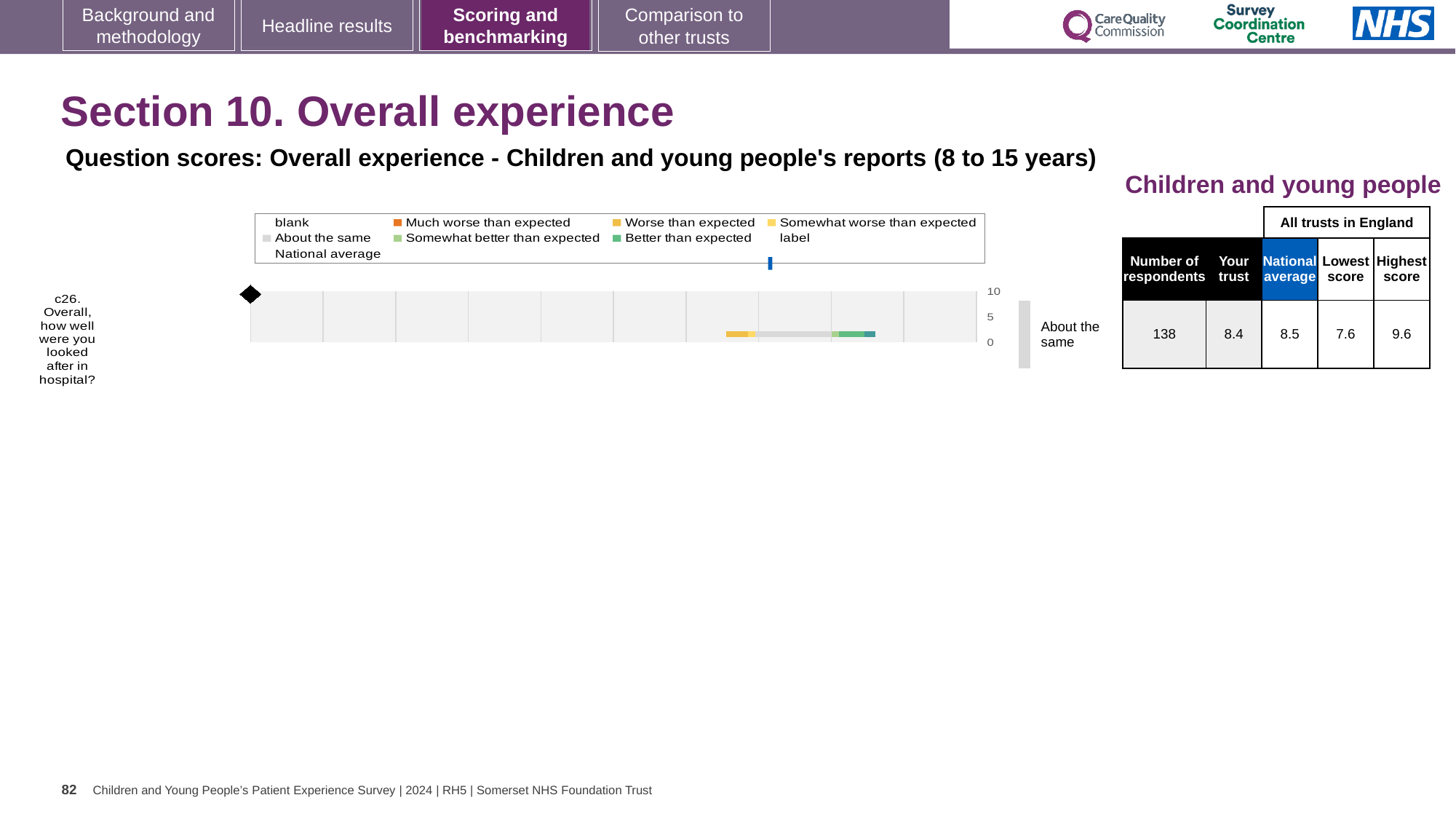
Which survey question is plotted in the chart? c26. Overall, how well were you looked after in hospital? In the table, what is the national average score for question c26? 8.5 What kind of chart is shown on the slide? bar chart What is the difference between the highest score and the lowest score for question c26? 2.0 Which is larger for question c26: the 'Your trust' score or the national average? National average How many survey questions are plotted in the chart? 1 In the table, how many respondents answered question c26? 138 In the table, what is the lowest score among all trusts in England for question c26? 7.6 How many entries does the chart legend list? 9 In the table, what is the 'Your trust' score for question c26? 8.4 In the table, what is the highest score among all trusts in England for question c26? 9.6 What category label is shown to the right of the bar for question c26? About the same